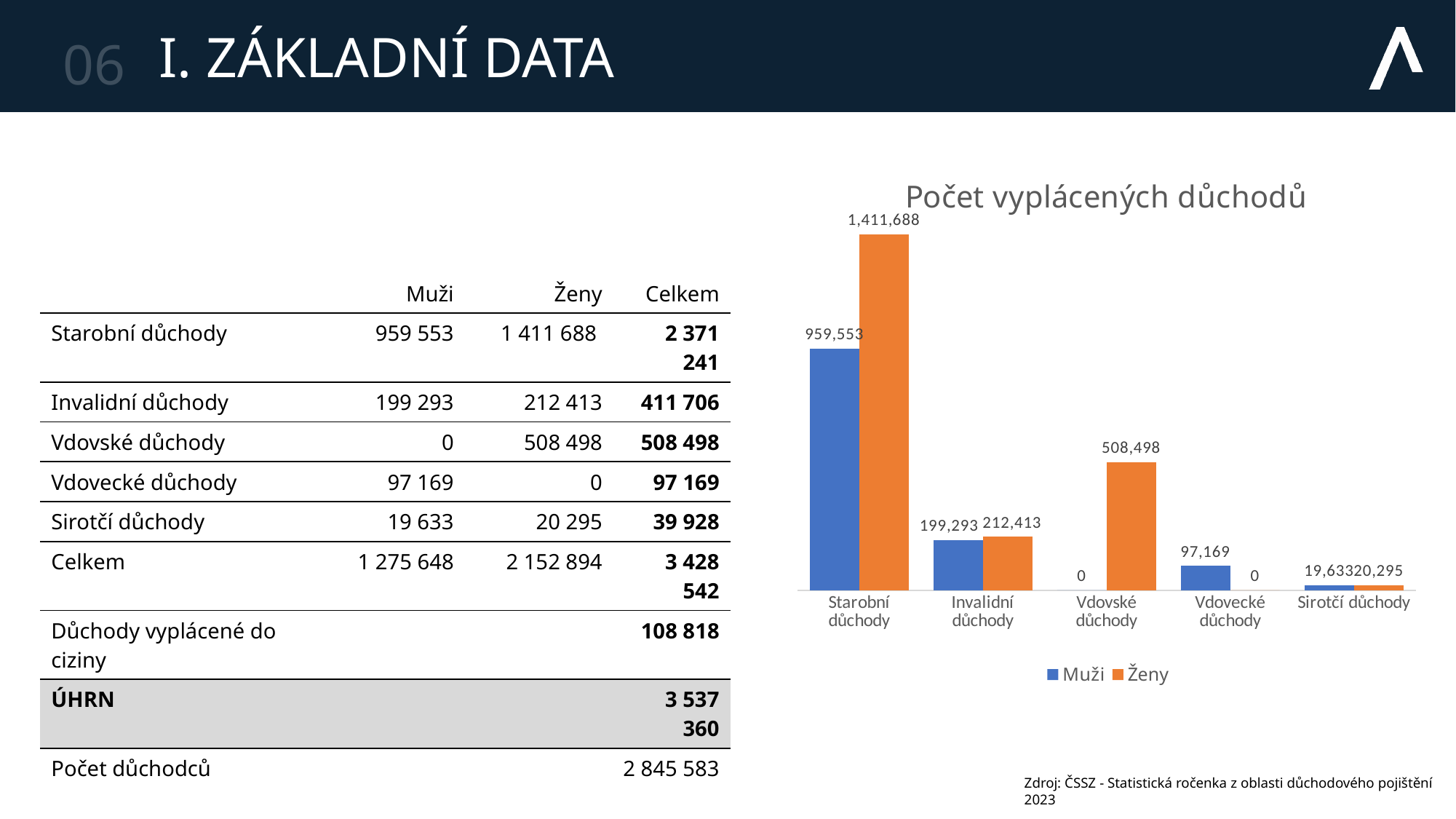
What is the value for Muži in the Vdovecké důchody category? 97,169 How many series does the chart legend list? 2 What is the difference between the Ženy and Muži values in the Starobní důchody category? 452,135 What is the value for Muži in the Invalidní důchody category? 199,293 How many categories are shown on the x axis of the chart? 5 What is the value for Ženy in the Vdovské důchody category? 508,498 What is the value for Ženy in the Starobní důchody category? 1,411,688 Which category has the highest value for Ženy? Starobní důchody Which category has the lowest value for Muži? Vdovské důchody What kind of chart is shown on the slide? bar chart Which is larger in the Sirotčí důchody category, the Muži value or the Ženy value? Ženy What is the title of the chart? Počet vyplácených důchodů